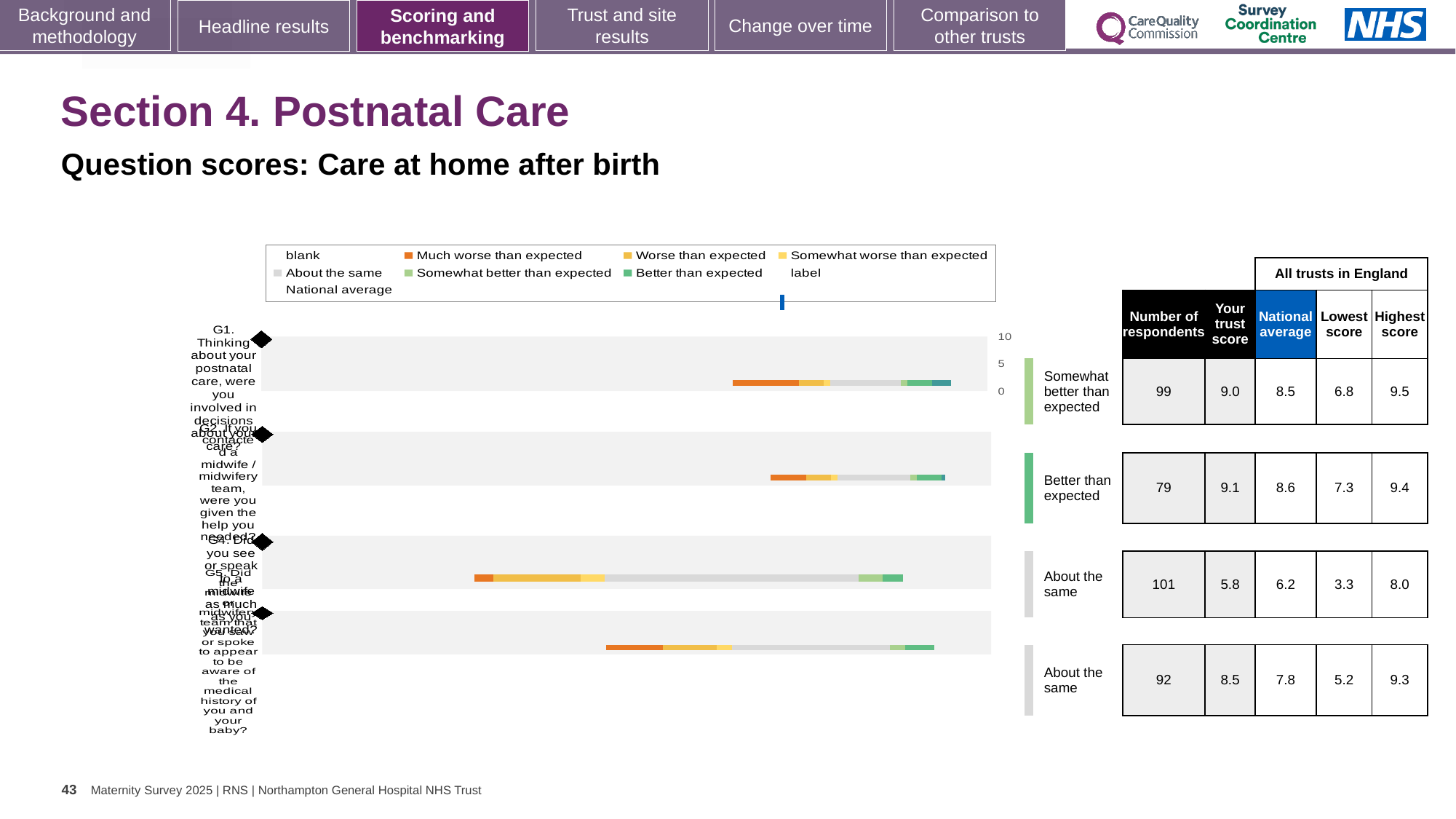
What is the subtitle of the chart section on the slide? Question scores: Care at home after birth In the table next to the chart, what is the highest score for the fourth row (About the same, 92 respondents)? 9.3 In the table next to the chart, what is the national average for the third row (About the same, 101 respondents)? 6.2 What kind of chart is shown on the slide? bar chart In the table next to the chart, what is the trust score for the row labelled Better than expected? 9.1 In the table next to the chart, which row has the highest number of respondents? the third row (About the same, 101 respondents) In the table next to the chart, which row has the lowest trust score? the third row (About the same, 101 respondents) In the table next to the chart, is the trust score for the row labelled Better than expected higher or lower than its national average? higher In the table next to the chart, what is the difference between the trust score and the national average for the first row (Somewhat better than expected)? 0.5 How many question bars are plotted in the chart? 4 In the table next to the chart, what is the lowest score for the row labelled Better than expected? 7.3 In the table next to the chart, what is the number of respondents for the first row (Somewhat better than expected)? 99